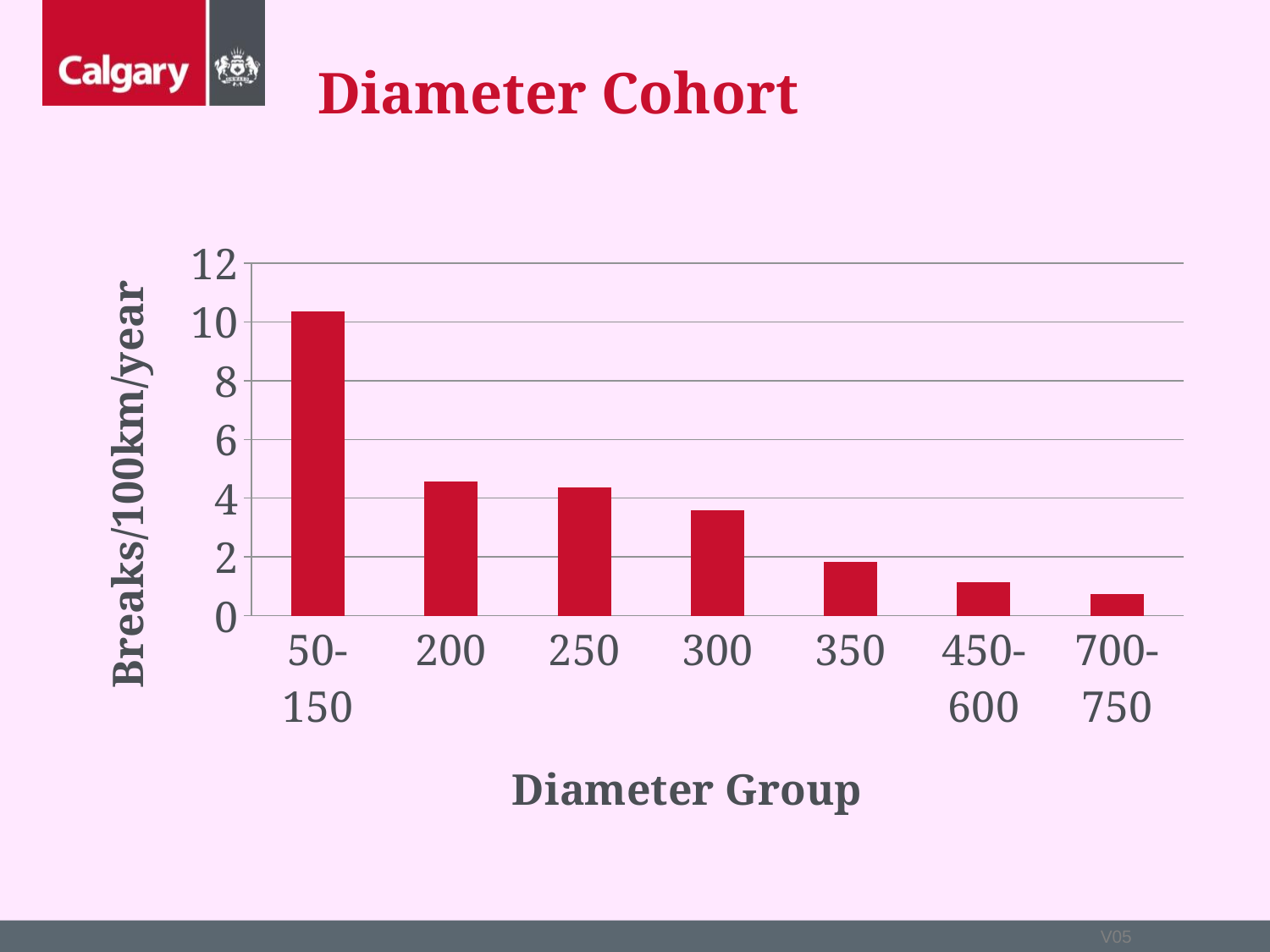
Which diameter group has the highest breaks/100km/year? 50-150 How many diameter groups are shown on the x axis? 7 Which has more breaks/100km/year, the 50-150 group or the 300 group? 50-150 What kind of chart is shown on the slide? bar chart What is the label of the y axis? Breaks/100km/year Is the value for the 300 diameter group greater or less than 2? greater Is the value for the 50-150 diameter group greater or less than 10? greater Do the breaks/100km/year rise or fall as the diameter group increases along the x axis? fall Is the value for the 200 diameter group greater or less than 6? less Which diameter group has the lowest breaks/100km/year? 700-750